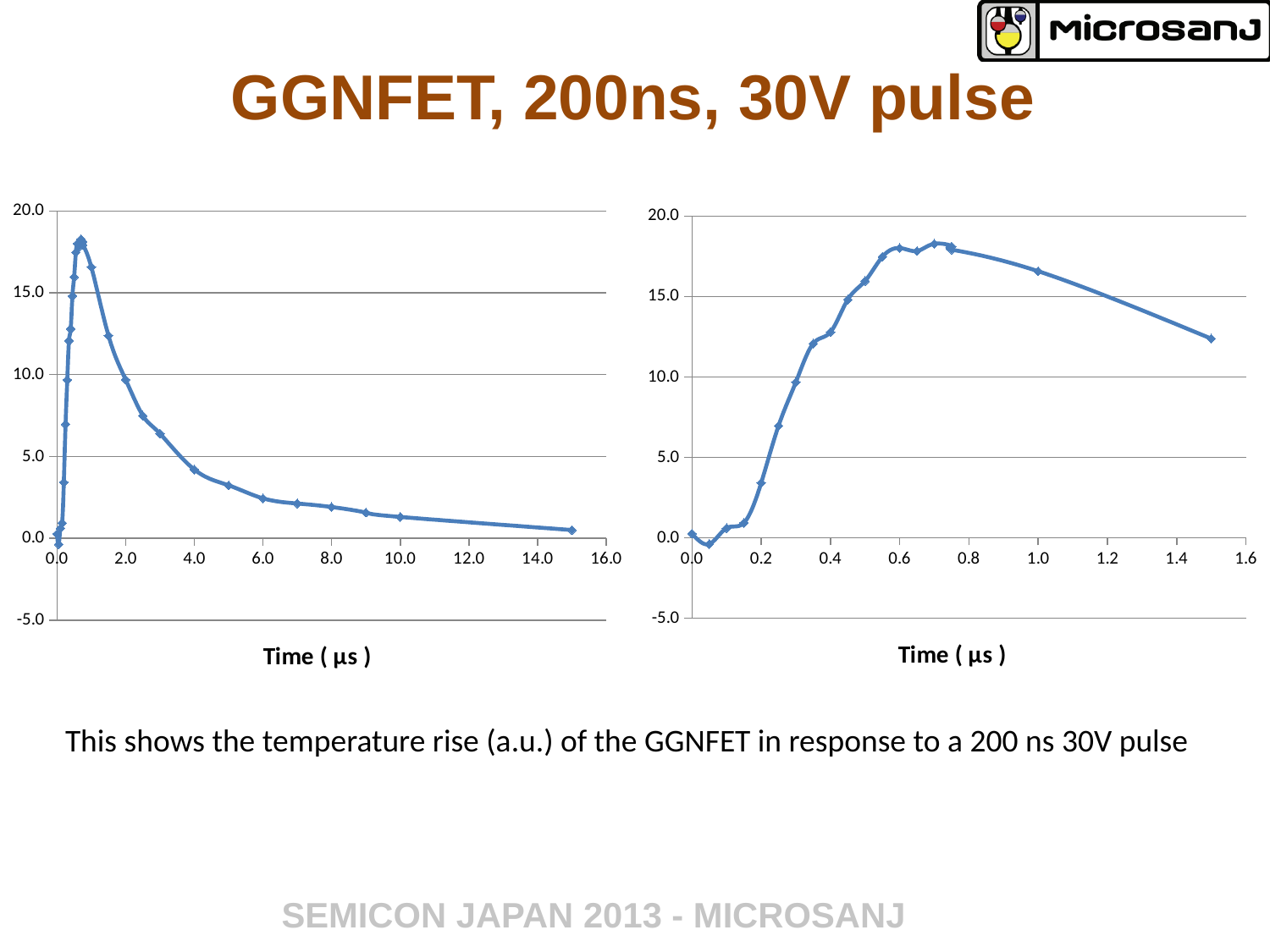
On the right chart, is the value at 1.0 μs greater or less than 15.0? greater On the left chart, is the value at 4.0 μs greater or less than 5.0? less On the right chart, is the value at 0.2 μs greater or less than 5.0? less How many charts are shown on the slide? 2 On the right chart, do the values rise or fall along the x axis between 0.0 and 0.6 μs? rise What kind of chart is the right chart on the slide? line chart What kind of chart is the left chart on the slide? line chart What is the x-axis label of the left chart? Time ( μs ) On the left chart, do the values rise or fall along the x axis between 2.0 and 16.0 μs? fall